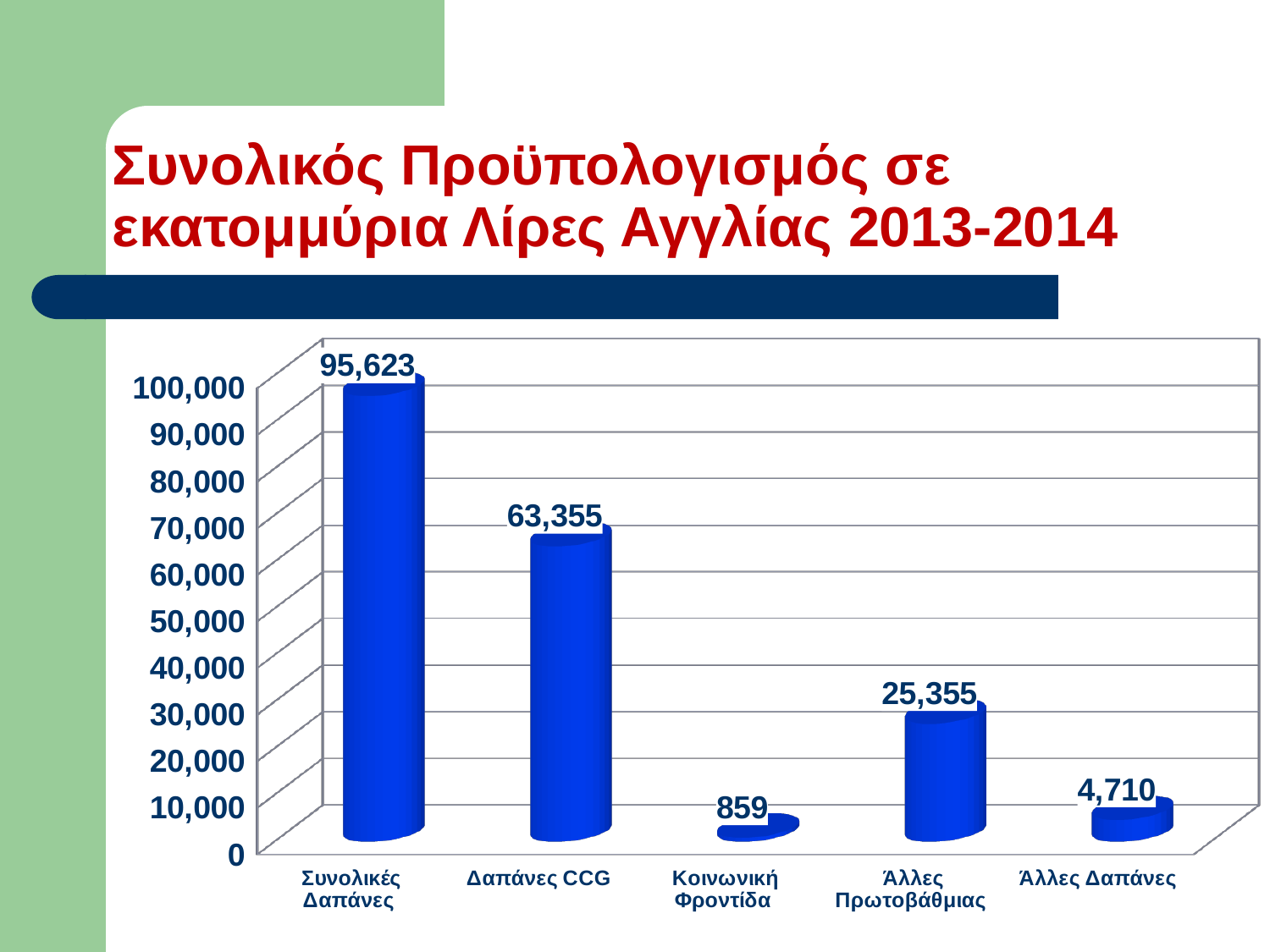
What is the value for Δαπάνες CCG? 63,355 How many categories are shown on the x axis? 5 What is the title of the slide? Συνολικός Προϋπολογισμός σε εκατομμύρια Λίρες Αγγλίας 2013-2014 What kind of chart is shown on the slide? Bar chart What is the value for Συνολικές Δαπάνες? 95,623 What is the value for Άλλες Πρωτοβάθμιας? 25,355 What is the value for Κοινωνική Φροντίδα? 859 Which category has the lowest value? Κοινωνική Φροντίδα Which is larger, the value for Άλλες Πρωτοβάθμιας or the value for Άλλες Δαπάνες? Άλλες Πρωτοβάθμιας Which category has the highest value? Συνολικές Δαπάνες What is the difference between the values for Συνολικές Δαπάνες and Δαπάνες CCG? 32,268 What is the value for Άλλες Δαπάνες? 4,710